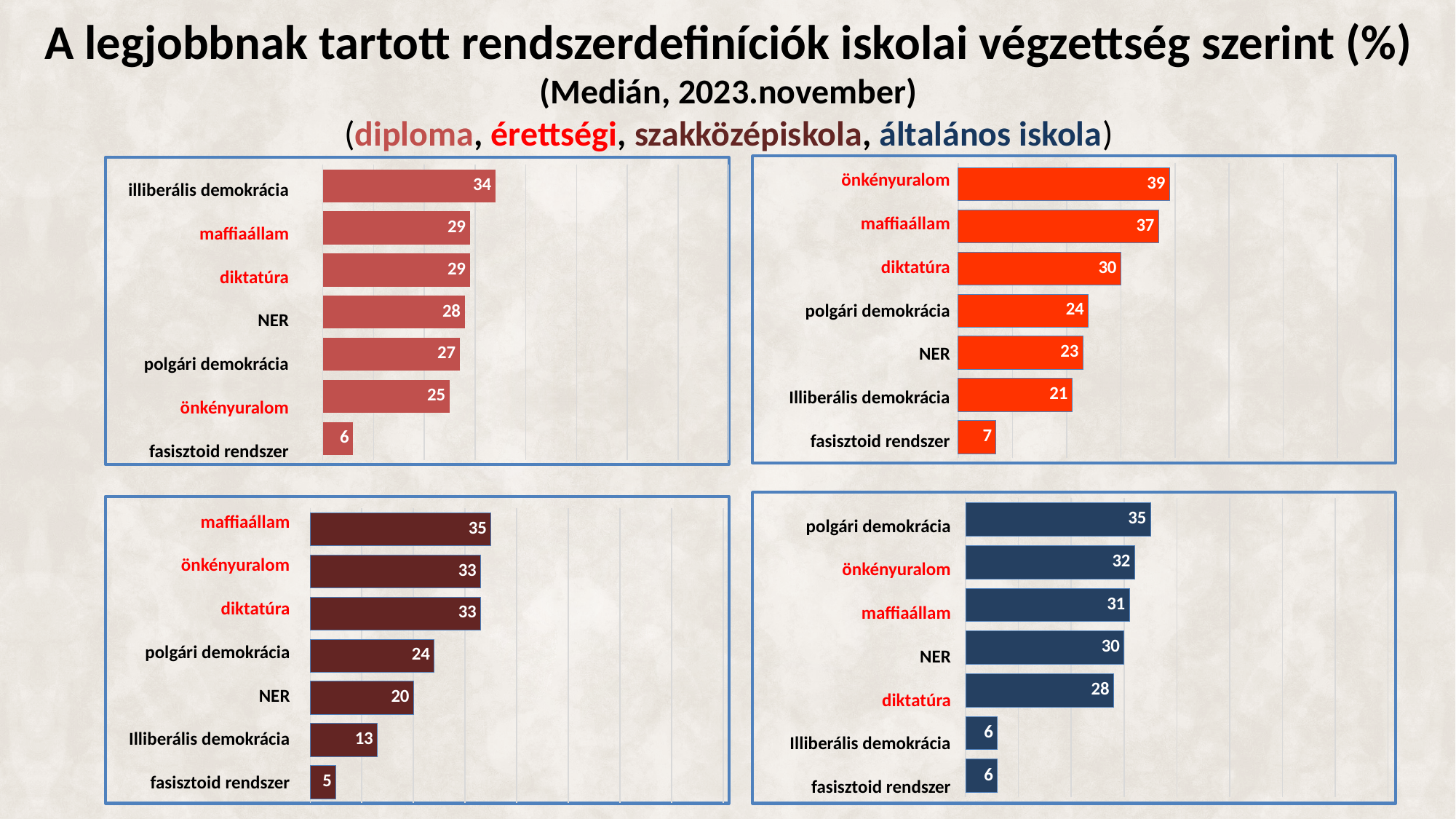
In the top-left chart, what is the value for illiberális demokrácia? 34 How many charts are on the slide? 4 What type of chart is the top-left chart? bar chart In the top-right chart, what is the difference between önkényuralom and maffiaállam? 2 In the bottom-left chart, which is larger, maffiaállam or polgári demokrácia? maffiaállam In the top-left chart, what is the value for fasisztoid rendszer? 6 How many categories are shown in the bottom-right chart? 7 In the bottom-right chart, what is the difference between polgári demokrácia and diktatúra? 7 In the top-right chart, which category has the highest value? önkényuralom In the bottom-left chart, what is the value for Illiberális demokrácia? 13 In the bottom-right chart, what is the value for NER? 30 In the bottom-left chart, which category has the lowest value? fasisztoid rendszer